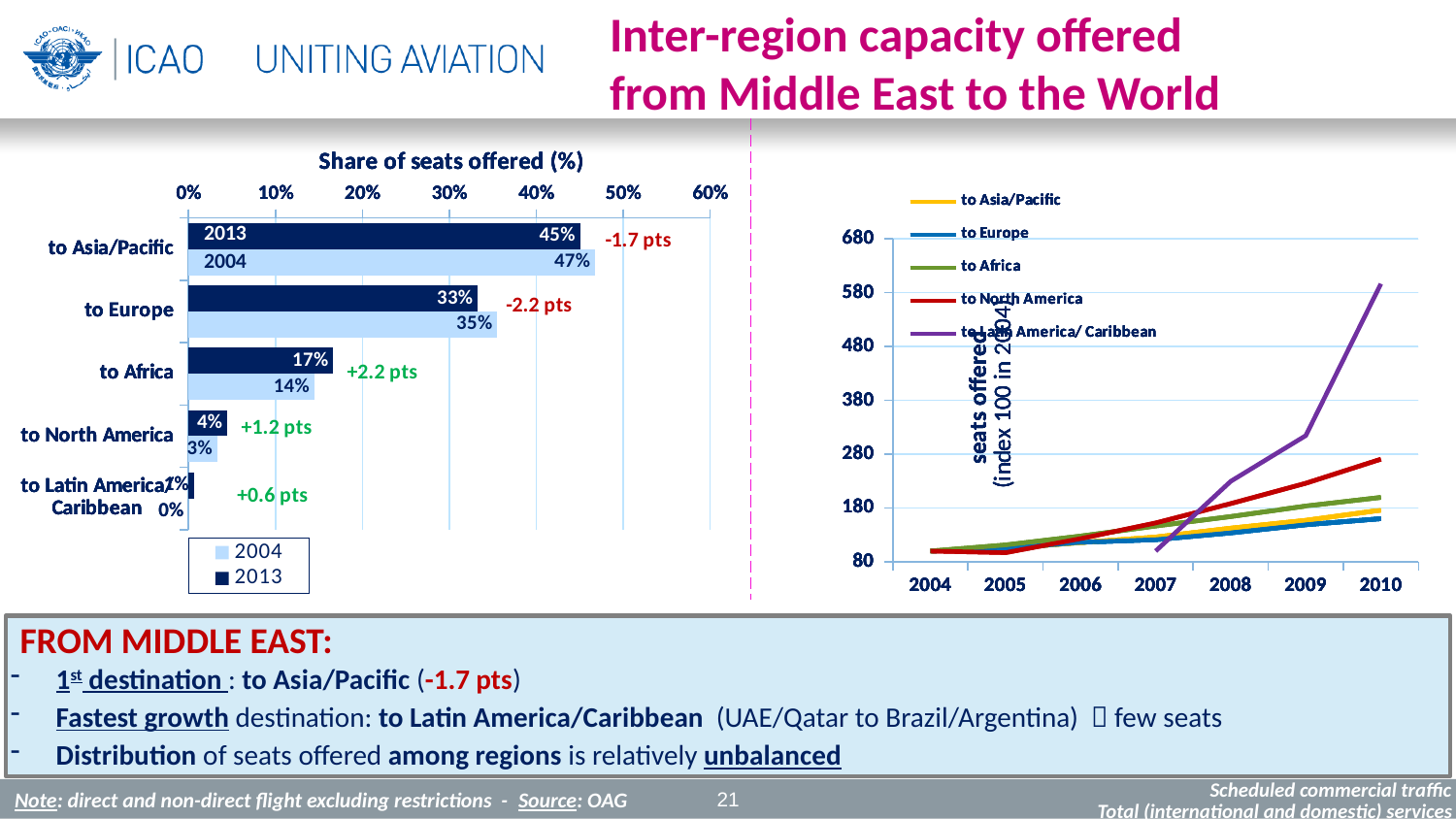
In the 'Share of seats offered (%)' bar chart, what is the 2004 share for 'to Europe'? 35% In the 'Share of seats offered (%)' bar chart, what is the difference between the 2013 and 2004 shares for 'to Africa'? +2.2 pts In the 'Share of seats offered (%)' bar chart, which destination has the highest 2013 share? to Asia/Pacific In the 'Share of seats offered (%)' bar chart, what is the 2013 share for 'to Africa'? 17% In the line chart on the right, is the 2010 value for 'to Latin America/Caribbean' greater or less than 480? greater What kind of chart is the chart on the right side of the slide? line chart How many series does the legend of the 'Share of seats offered (%)' chart list? 2 In the 'Share of seats offered (%)' bar chart, which destination has the lowest 2004 share? to Latin America/Caribbean In the 'Share of seats offered (%)' bar chart, what is the 2013 share for 'to Asia/Pacific'? 45% In the 'Share of seats offered (%)' bar chart, is the 2013 share for 'to Europe' larger or smaller than its 2004 share? smaller How many destination categories does the 'Share of seats offered (%)' bar chart show? 5 How many series does the legend of the line chart on the right list? 5